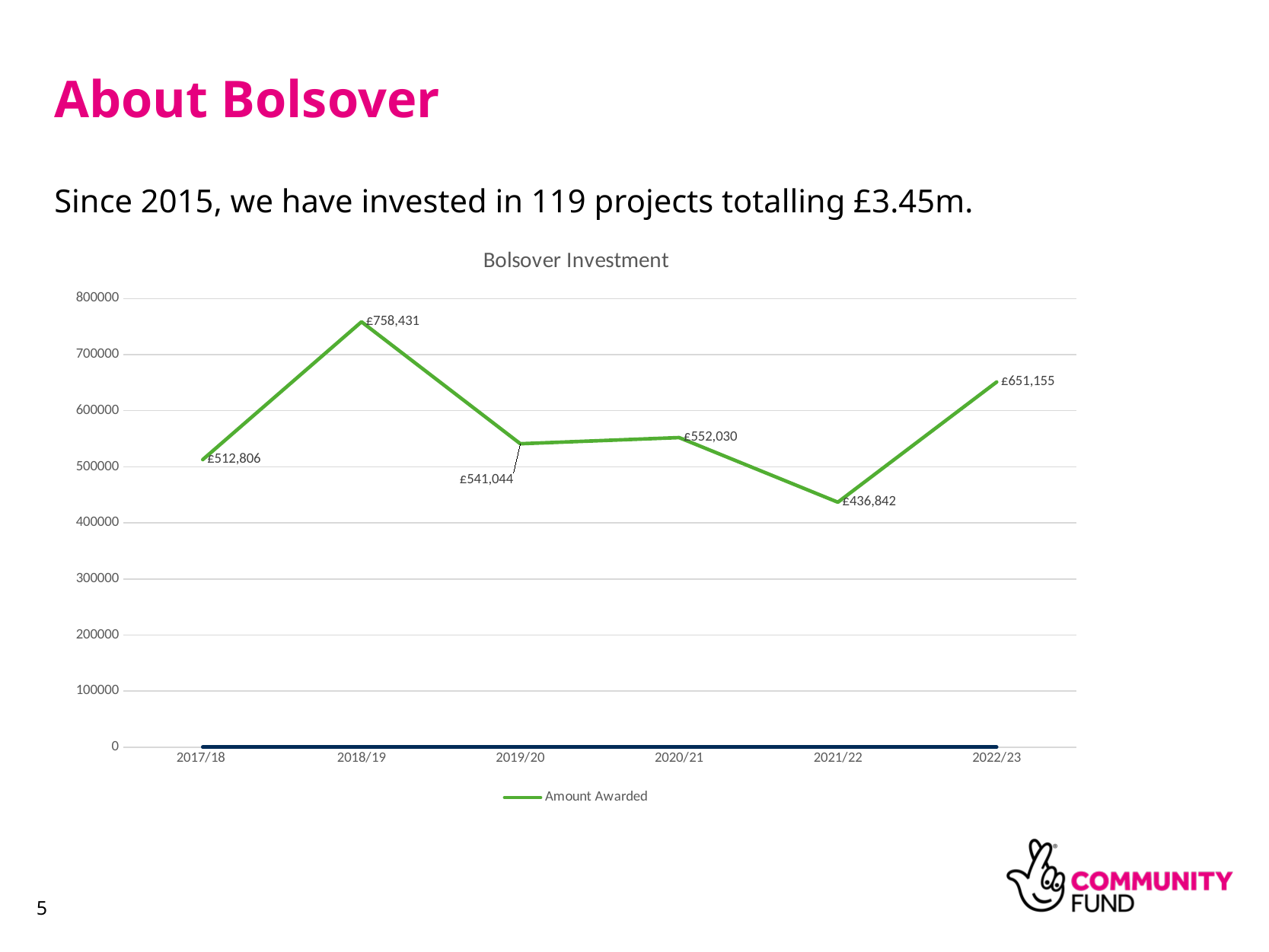
What is the difference between the amount awarded in 2022/23 and in 2021/22? £214,313 How many series does the legend list? 1 What is the amount awarded for 2022/23? £651,155 What is the amount awarded for 2021/22? £436,842 What is the amount awarded for 2018/19? £758,431 What is the difference between the amount awarded in 2018/19 and in 2017/18? £245,625 How many years are plotted on the x axis? 6 What is the title of the chart? Bolsover Investment What type of chart is shown on the slide? Line chart Which year has the highest amount awarded? 2018/19 Which year has the lowest amount awarded? 2021/22 Which year has the larger amount awarded, 2019/20 or 2020/21? 2020/21